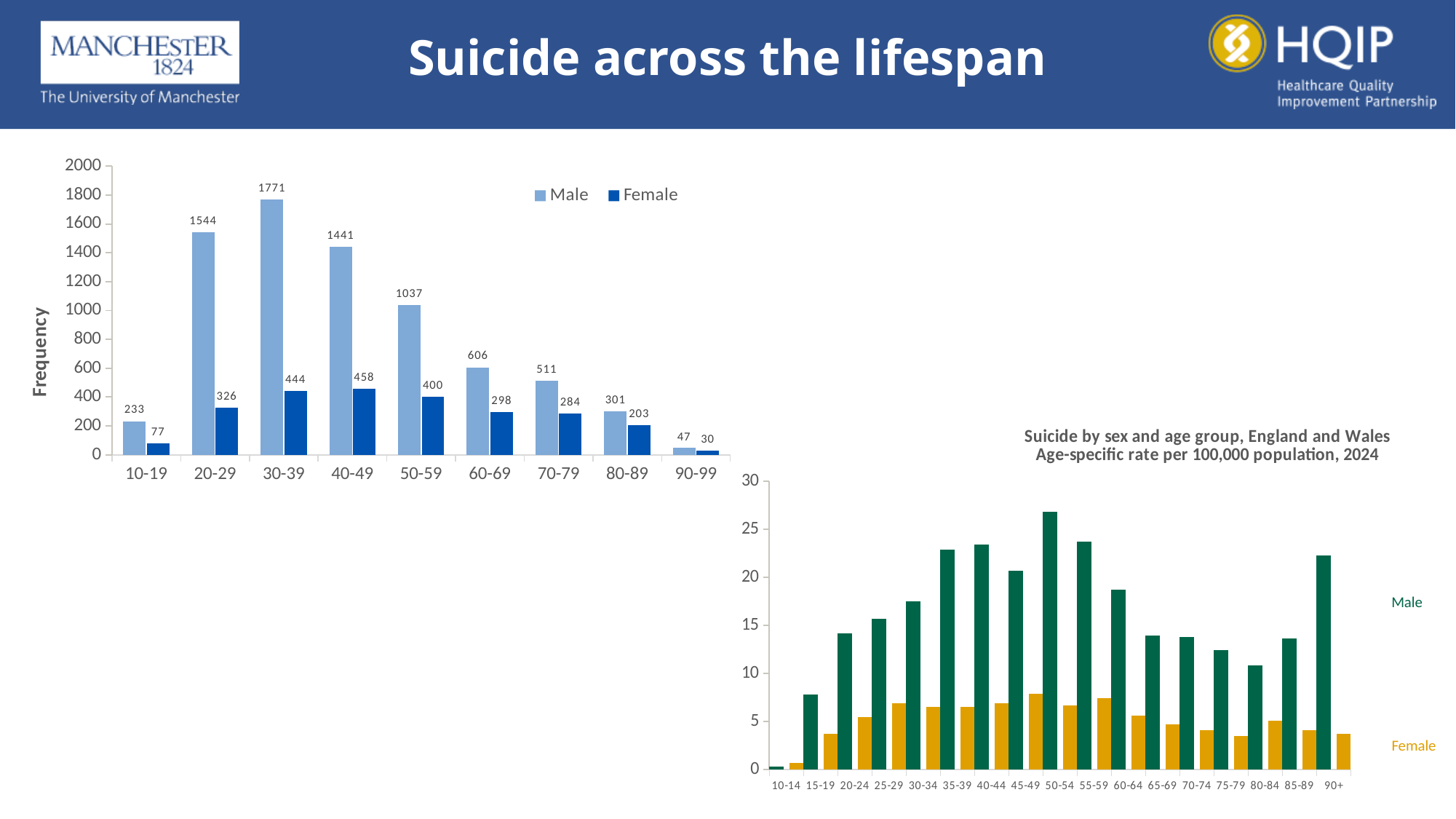
In the right chart (Suicide by sex and age group, England and Wales), is the Male value for 50-54 greater or less than 25? greater In the left chart (Frequency by age group), how many series does the legend list? 2 In the left chart (Frequency by age group), how many age groups are shown on the x axis? 9 In the right chart (Suicide by sex and age group, England and Wales), how many age groups are shown on the x axis? 17 In the left chart (Frequency by age group), what is the Male value for the 30-39 age group? 1771 In the left chart (Frequency by age group), which age group has the highest Male value? 30-39 In the left chart (Frequency by age group), which age group has the lowest Female value? 90-99 In the right chart (Suicide by sex and age group, England and Wales), which age group has the highest Male rate? 50-54 In the left chart (Frequency by age group), which is larger: the Female value for 50-59 or the Female value for 60-69? Female value for 50-59 What kind of chart is the right chart titled 'Suicide by sex and age group, England and Wales'? Bar chart In the left chart (Frequency by age group), what is the difference between the Male and Female values for the 20-29 age group? 1218 In the left chart (Frequency by age group), what is the Female value for the 40-49 age group? 458